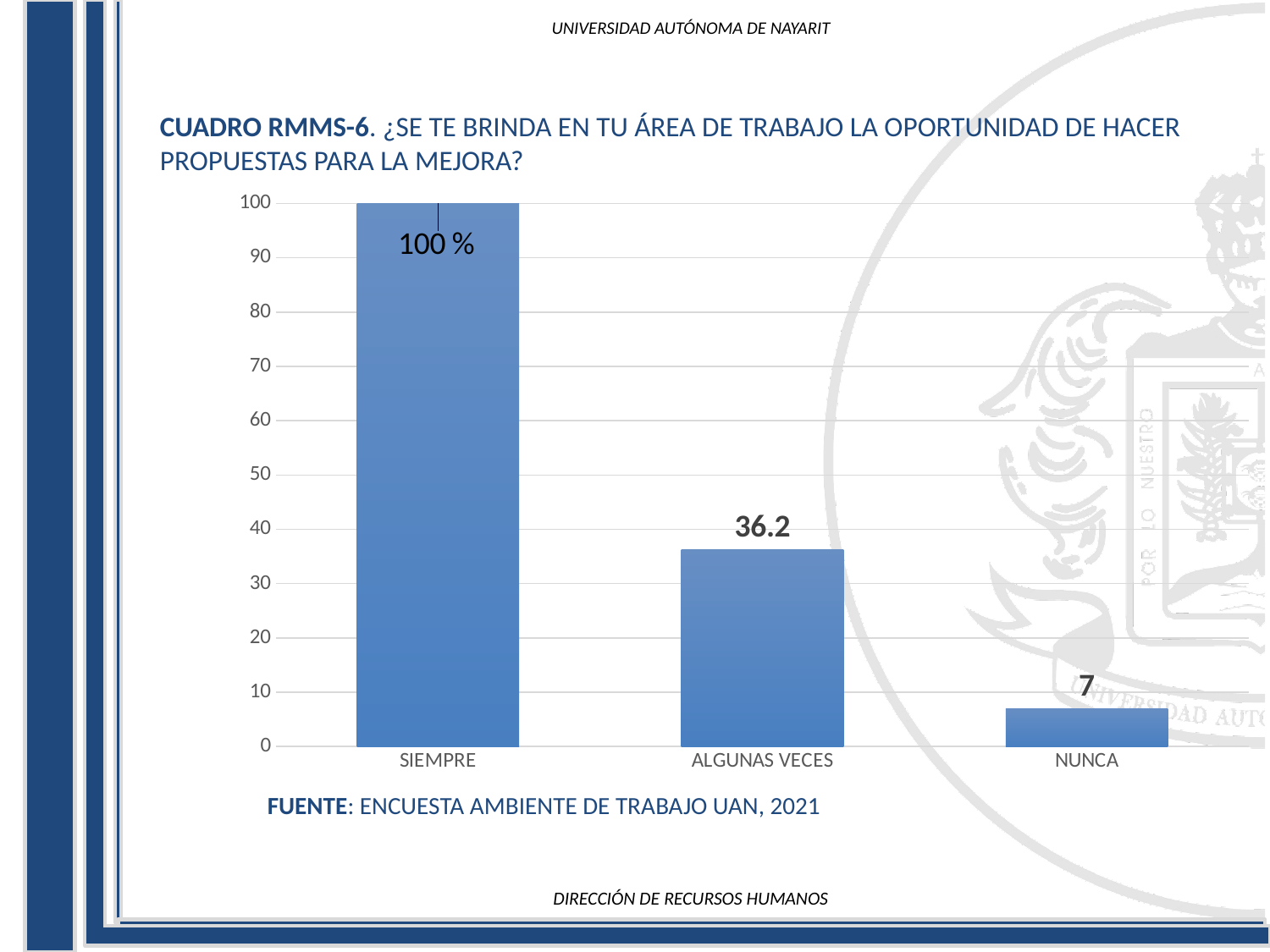
What value is shown for SIEMPRE? 100 % What value is shown for NUNCA? 7 Which is larger, the value for ALGUNAS VECES or the value for NUNCA? ALGUNAS VECES Which category has the lowest value? NUNCA What value is shown for ALGUNAS VECES? 36.2 Which category has the highest value? SIEMPRE What is the difference between the values for ALGUNAS VECES and NUNCA? 29.2 How many categories are shown on the x axis? 3 Is the value for NUNCA greater or less than 10? less What kind of chart is shown on the slide? bar chart What source is cited below the chart? ENCUESTA AMBIENTE DE TRABAJO UAN, 2021 Is the value for ALGUNAS VECES greater or less than 40? less